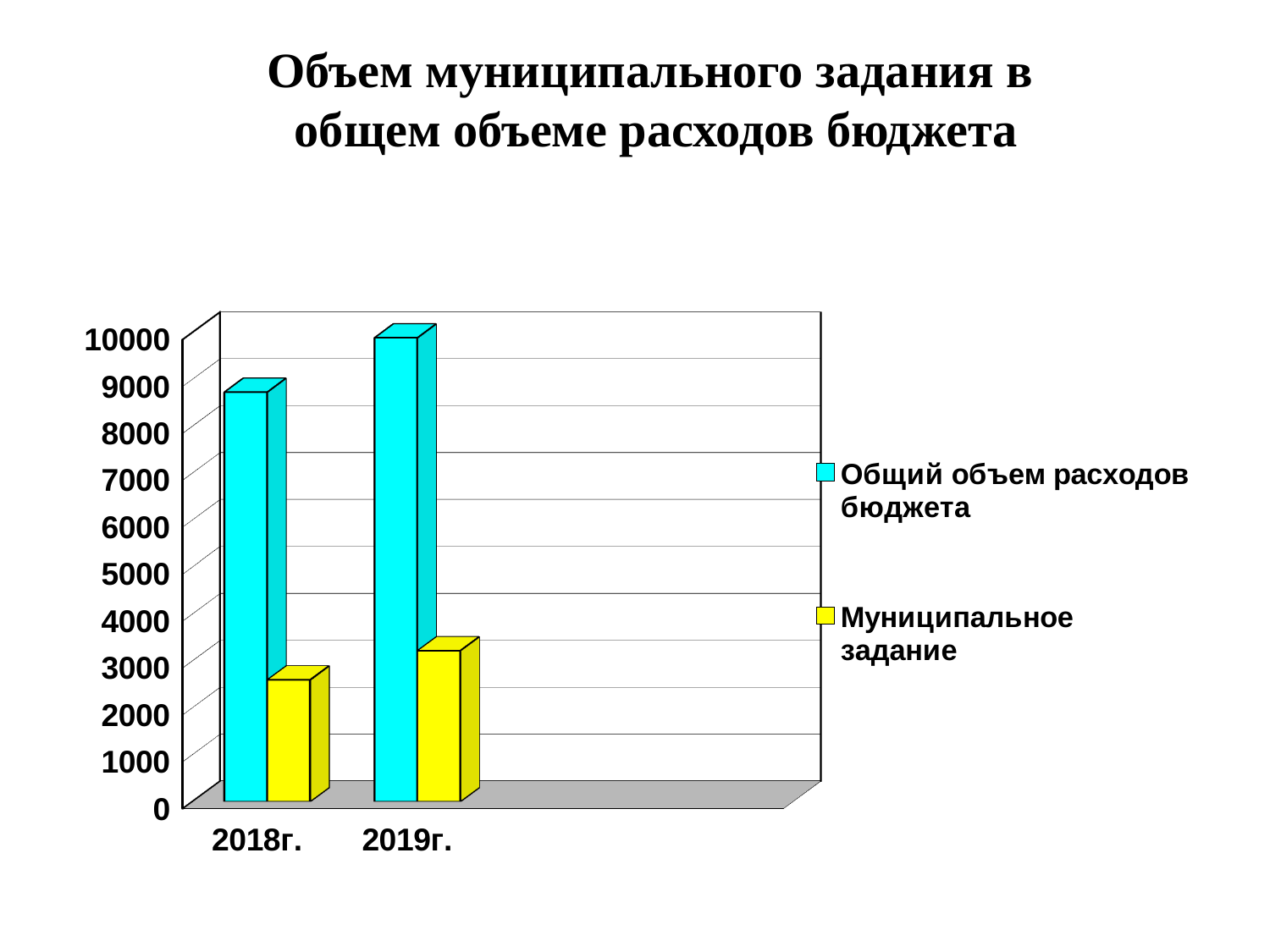
Is the value for Общий объем расходов бюджета in 2019г. greater or less than 9000? greater What kind of chart is shown on the slide? bar chart Which year has the higher value for Общий объем расходов бюджета, 2018г. or 2019г.? 2019г. Is the value for Муниципальное задание in 2018г. greater or less than 2000? greater What is the title of the chart? Объем муниципального задания в общем объеме расходов бюджета Is the value for Общий объем расходов бюджета in 2018г. greater or less than 8000? greater Which series is shown in yellow? Муниципальное задание How many series does the legend list? 2 How many categories (years) are shown on the x axis? 2 Do the values for Общий объем расходов бюджета rise or fall from 2018г. to 2019г.? rise Which year has the higher value for Муниципальное задание, 2018г. or 2019г.? 2019г.